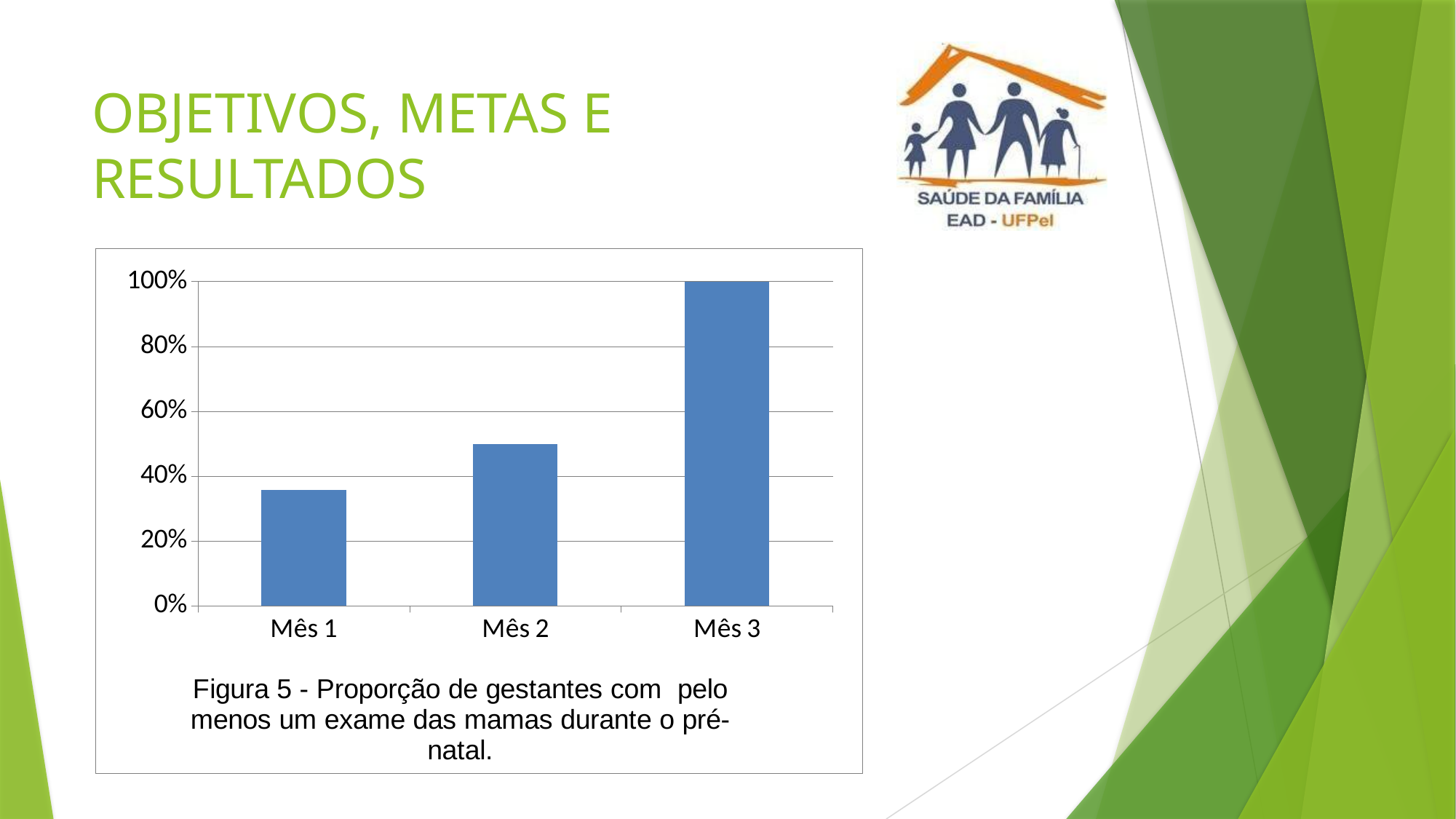
Is the value for Mês 2 greater or less than 60%? less How many months are shown on the x axis? 3 Is the value for Mês 2 greater or less than 40%? greater What figure number is given in the caption below the chart? Figura 5 Is the value for Mês 1 greater or less than 40%? less Which month has the highest value? Mês 3 Which month has the lowest value? Mês 1 What kind of chart is shown on the slide? bar chart Do the values rise or fall from Mês 1 to Mês 3? rise Which is larger, the value for Mês 1 or the value for Mês 2? Mês 2 What is the value for Mês 3? 100%